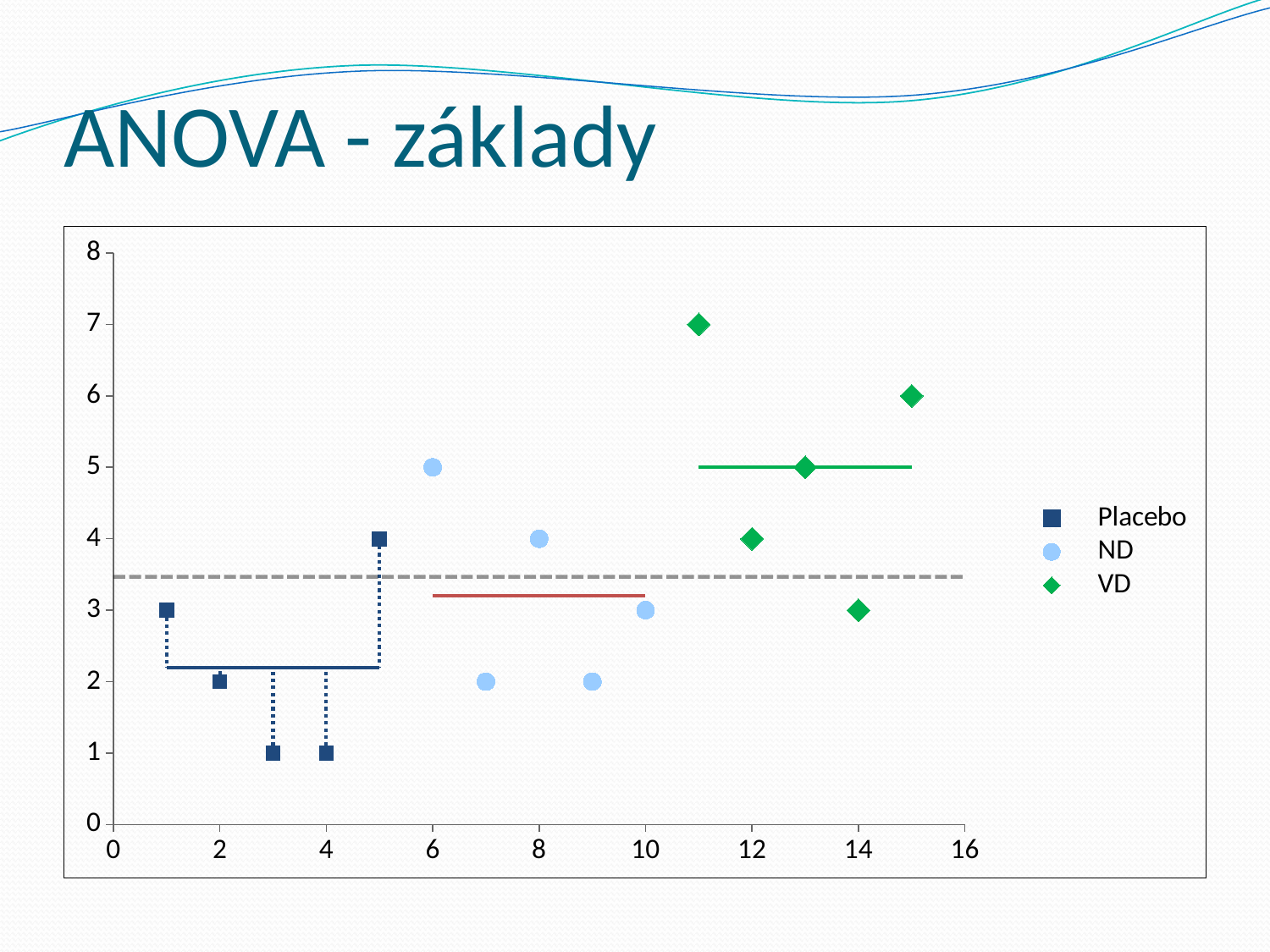
How many series does the legend list? 3 Which series contains the highest point on the chart? VD What is the y value of the VD point at x = 14? 3 What is the difference between the VD point at x = 11 and the Placebo point at x = 3? 6 What is the y value of the VD point at x = 11? 7 What are the names of the series in the legend? Placebo, ND, VD What kind of chart is shown on the slide? scatter chart How many data points does the Placebo series have? 5 What is the y value of the ND point at x = 6? 5 What is the y value of the Placebo point at x = 5? 4 What is the lowest y value plotted on the chart? 1 Which is larger: the ND point at x = 8 or the Placebo point at x = 2? the ND point at x = 8